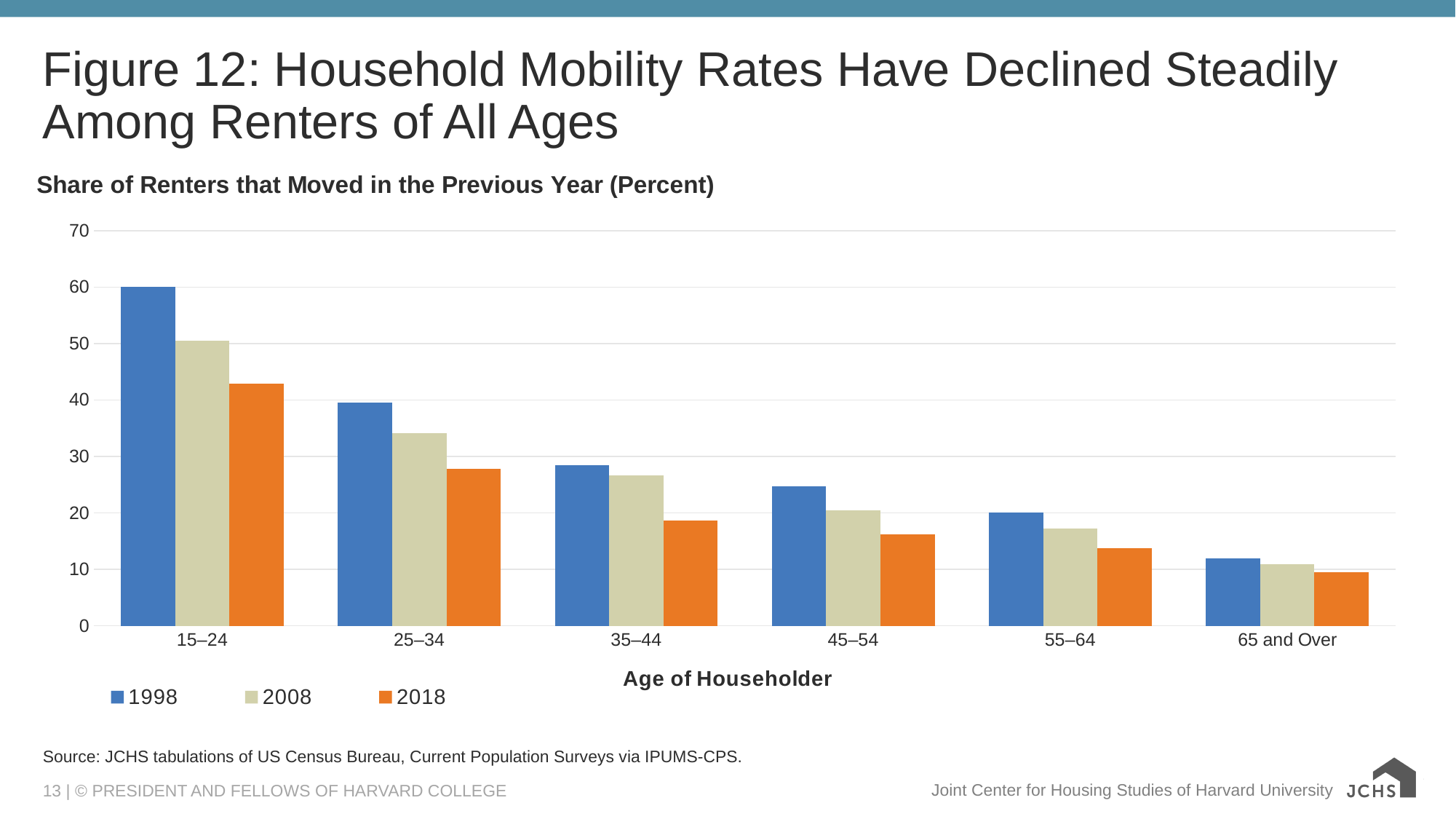
Is the value for 2008 in the 35–44 age group greater or less than 20? greater Is the value for 2018 in the 55–64 age group greater or less than 10? greater Which age group has the lowest value for 2018? 65 and Over How many series does the legend list? 3 What is the title of the x axis? Age of Householder What kind of chart is shown on the slide? bar chart Which age group has the highest value for 1998? 15–24 Do the values for 2008 rise or fall as the age of householder increases along the x axis? fall For the 45–54 age group, which is larger: the value for 1998 or the value for 2018? 1998 Is the value for 2018 in the 25–34 age group greater or less than 30? less How many age groups are shown on the x axis? 6